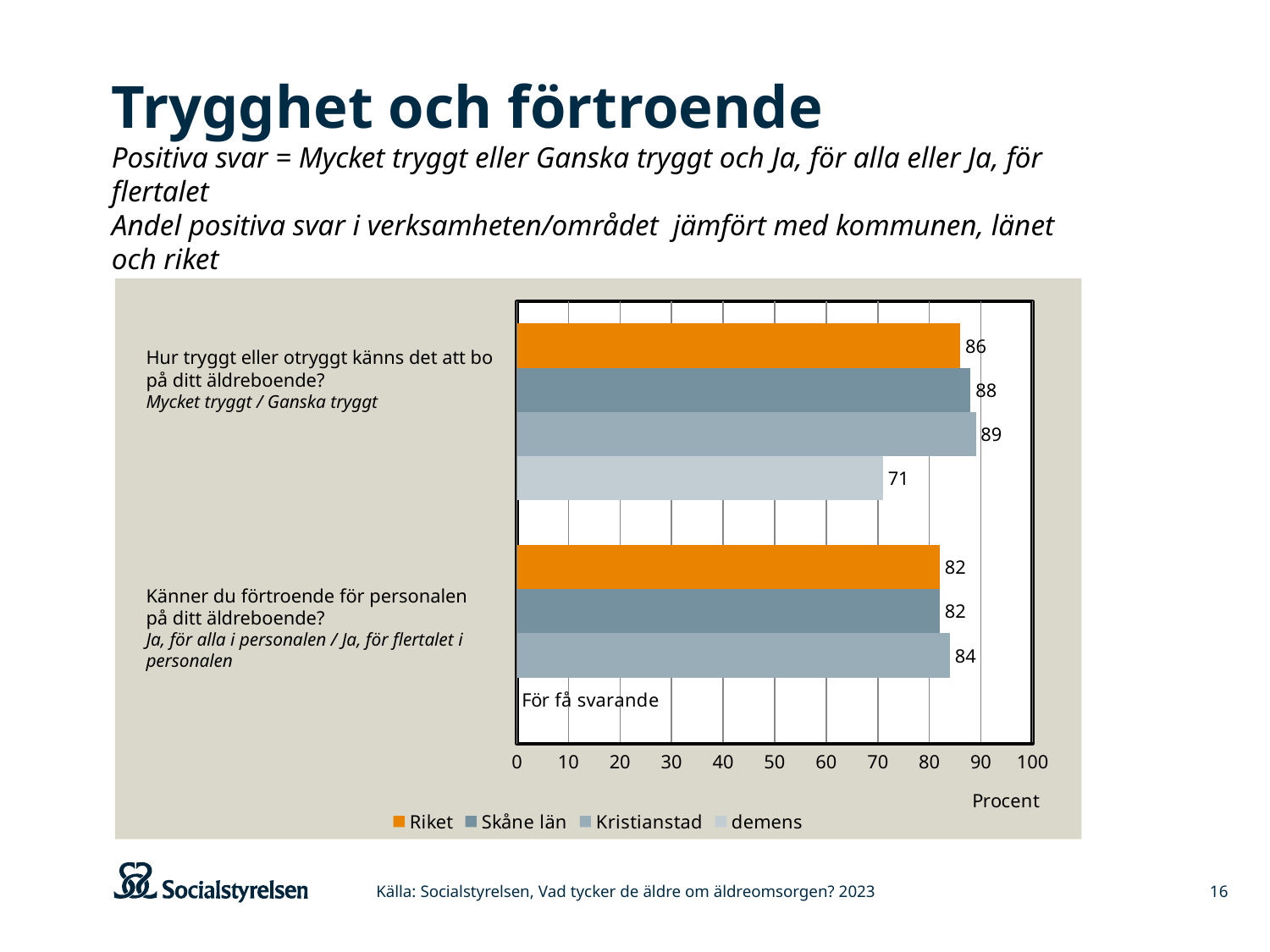
What is the label on the x axis of the chart? Procent What is the difference between the Kristianstad and demens values for the question "Hur tryggt eller otryggt känns det att bo på ditt äldreboende?"? 18 For the question "Känner du förtroende för personalen på ditt äldreboende?", which is larger: the value for Kristianstad or the value for Riket? Kristianstad Which series has the lowest value for the question "Hur tryggt eller otryggt känns det att bo på ditt äldreboende?"? demens What is the value for demens for the question "Hur tryggt eller otryggt känns det att bo på ditt äldreboende?"? 71 What is shown for the demens series for the question "Känner du förtroende för personalen på ditt äldreboende?"? För få svarande What is the difference between the Skåne län values for the two questions? 6 How many series does the legend list? 4 What is the value for Riket for the question "Hur tryggt eller otryggt känns det att bo på ditt äldreboende?"? 86 Which series has the highest value for the question "Hur tryggt eller otryggt känns det att bo på ditt äldreboende?"? Kristianstad What kind of chart is shown on the slide? bar chart What is the value for Kristianstad for the question "Känner du förtroende för personalen på ditt äldreboende?"? 84